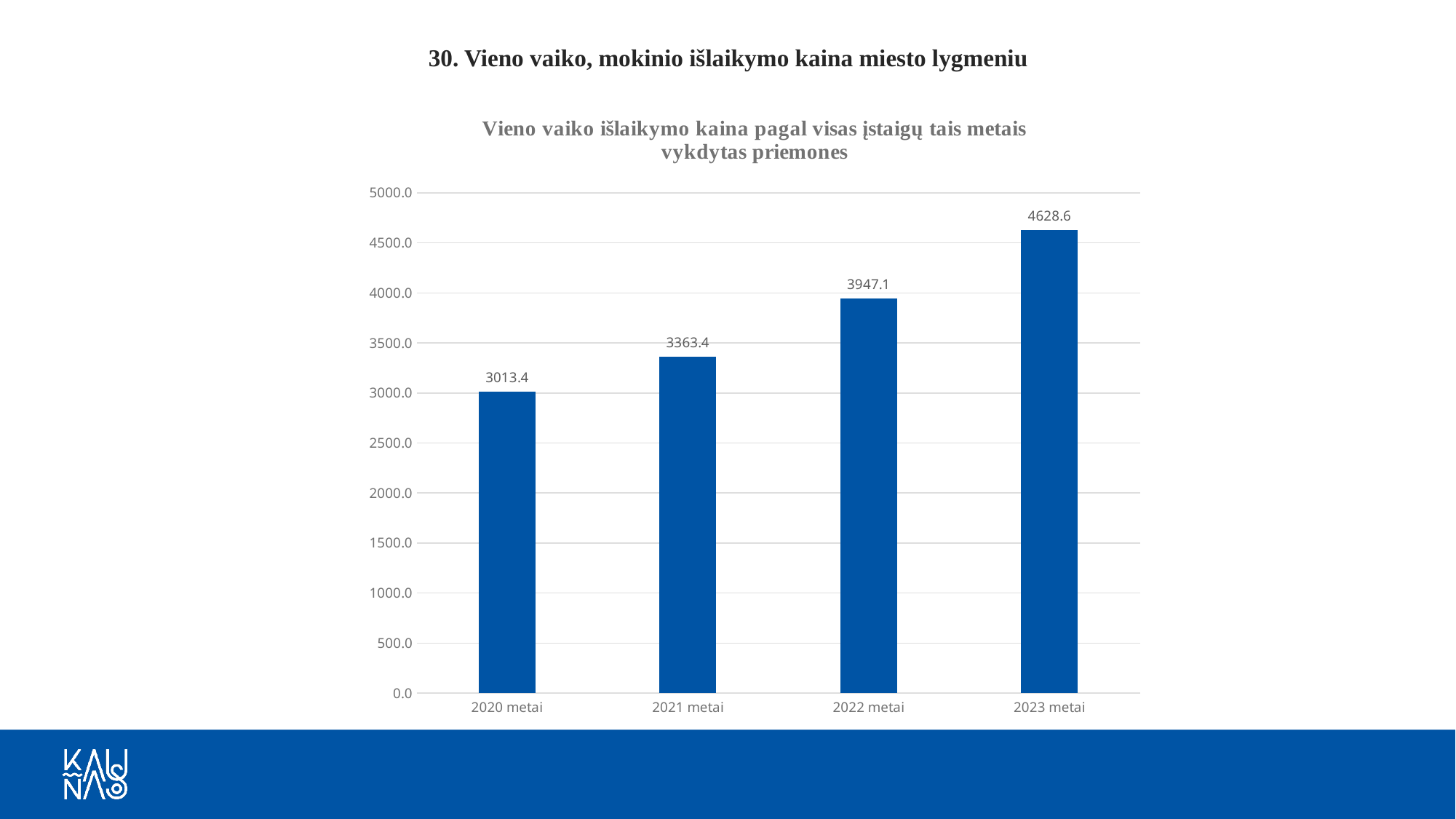
How many years are shown on the chart? 4 Which is larger, the value for 2021 metai or 2022 metai? 2022 metai Which year has the lowest value? 2020 metai Do the values rise or fall from 2020 metai to 2023 metai? Rise What is the difference between the values for 2022 metai and 2021 metai? 583.7 What is the value for 2022 metai? 3947.1 What is the value for 2021 metai? 3363.4 What is the value for 2020 metai? 3013.4 Which year has the highest value? 2023 metai What kind of chart is shown? Bar chart What is the value for 2023 metai? 4628.6 What is the difference between the values for 2023 metai and 2020 metai? 1615.2